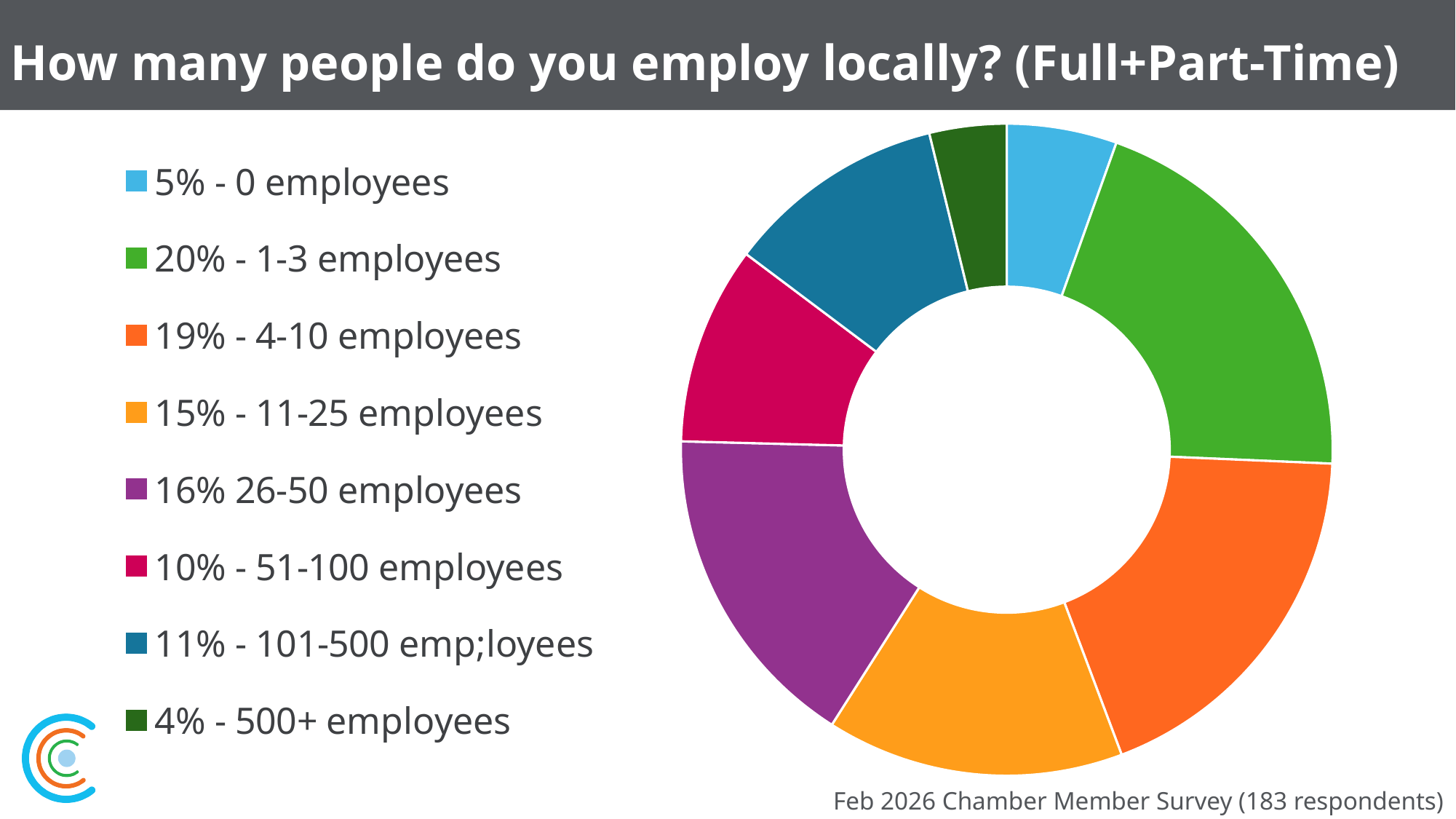
Which employee-count category has the largest share? 1-3 employees What is the difference in percentage points between the 4-10 employees share and the 51-100 employees share? 9 What share of respondents employ 500+ employees locally? 4% How many respondents took part in the survey, according to the note on the slide? 183 What is the combined share of respondents with 0 employees and 1-3 employees? 25% What kind of chart is shown on the slide? Doughnut (pie) chart What share of respondents employ 11-25 employees locally? 15% Which employee-count category has the smallest share? 500+ employees Which is larger: the share for 26-50 employees or the share for 11-25 employees? 26-50 employees How many employee-count categories does the chart show? 8 What share of respondents employ 101-500 employees locally? 11% What share of respondents employ 1-3 employees locally? 20%